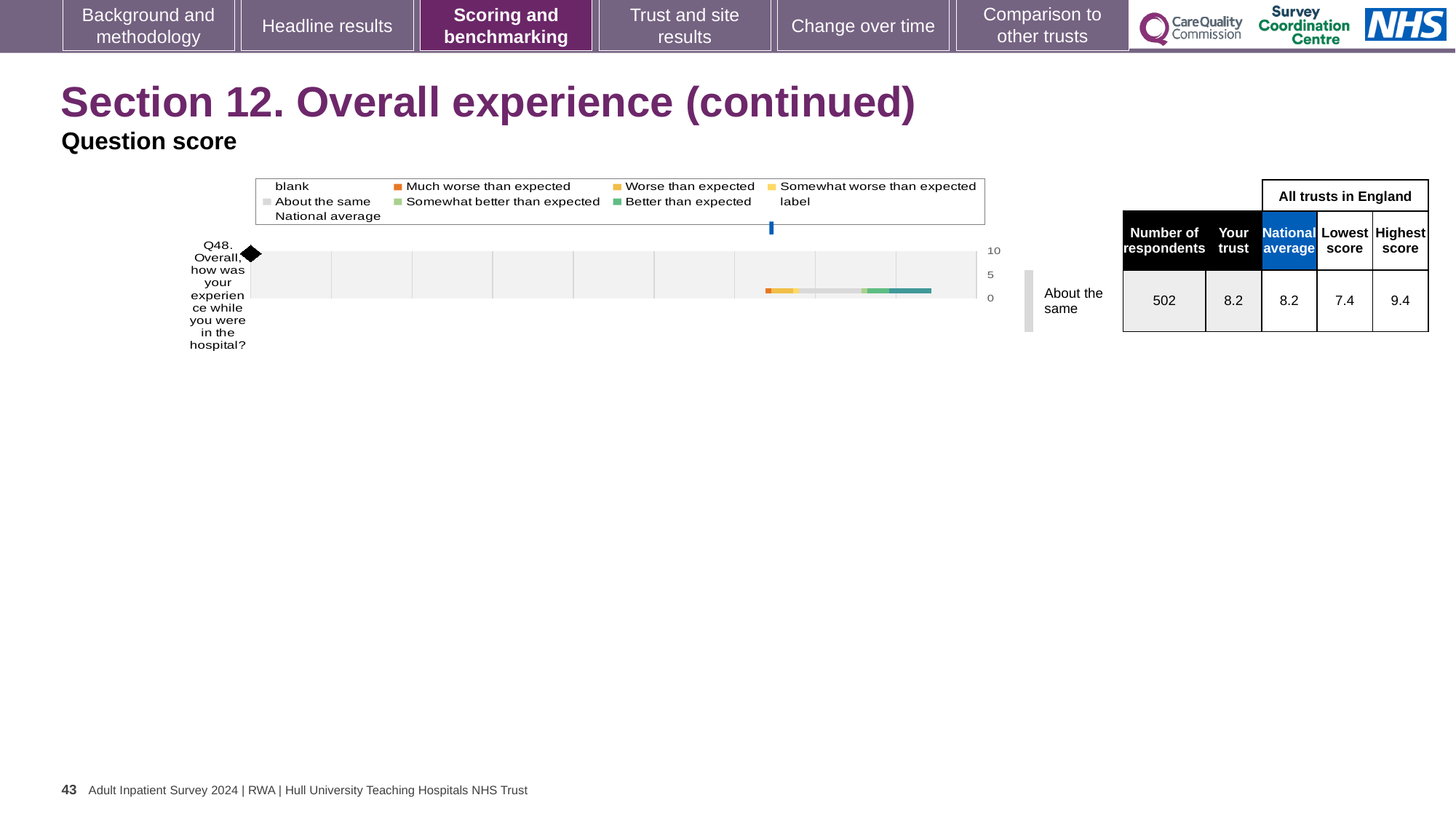
Which benchmark category is the trust's Q48 score placed in? About the same Is the trust's score for Q48 higher than, lower than, or the same as the national average? the same What is the difference between the highest and lowest scores among all trusts in England for Q48? 2.0 How many survey questions are plotted in the chart? 1 What type of chart is used to show the Q48 question score? bar chart Is the trust's score for Q48 greater or less than 5? greater Which question is plotted in the chart? Q48. Overall, how was your experience while you were in the hospital? What is the national average score for Q48? 8.2 What is the lowest score among all trusts in England for Q48? 7.4 What is the number of respondents for Q48? 502 What is the 'Your trust' score for Q48? 8.2 What is the highest score among all trusts in England for Q48? 9.4